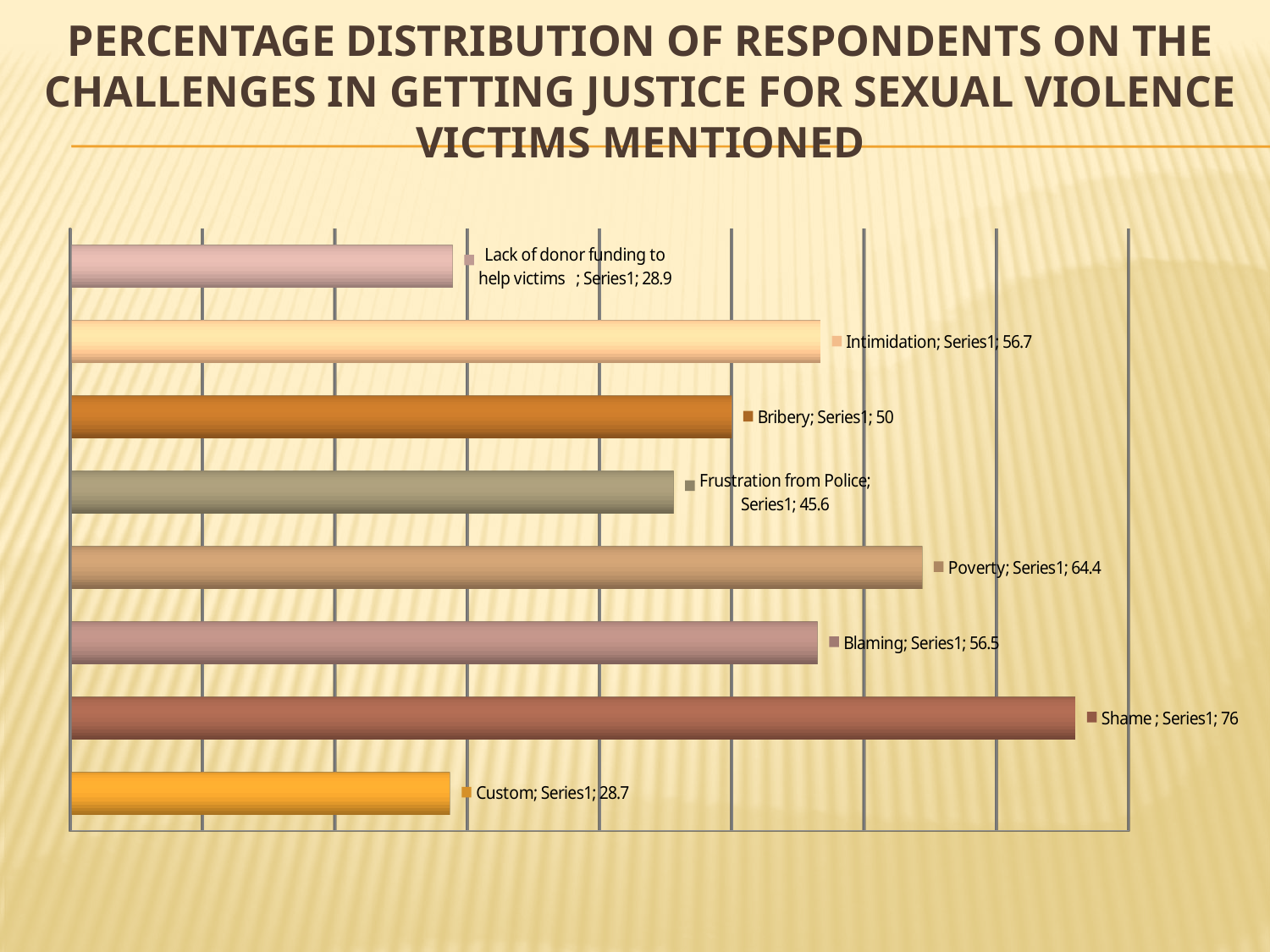
What is the value for Lack of donor funding to help victims? 28.9 What is the value for Bribery? 50 What is the value for Shame? 76 Which is larger, the value for Poverty or the value for Intimidation? Poverty Which category has the lowest value? Custom What is the difference between the values for Poverty and Bribery? 14.4 What series name appears in the data labels? Series1 Which category has the highest value? Shame What is the difference between the values for Shame and Custom? 47.3 What is the value for Frustration from Police? 45.6 What kind of chart is shown on the slide? Bar chart How many categories are shown in the chart? 8